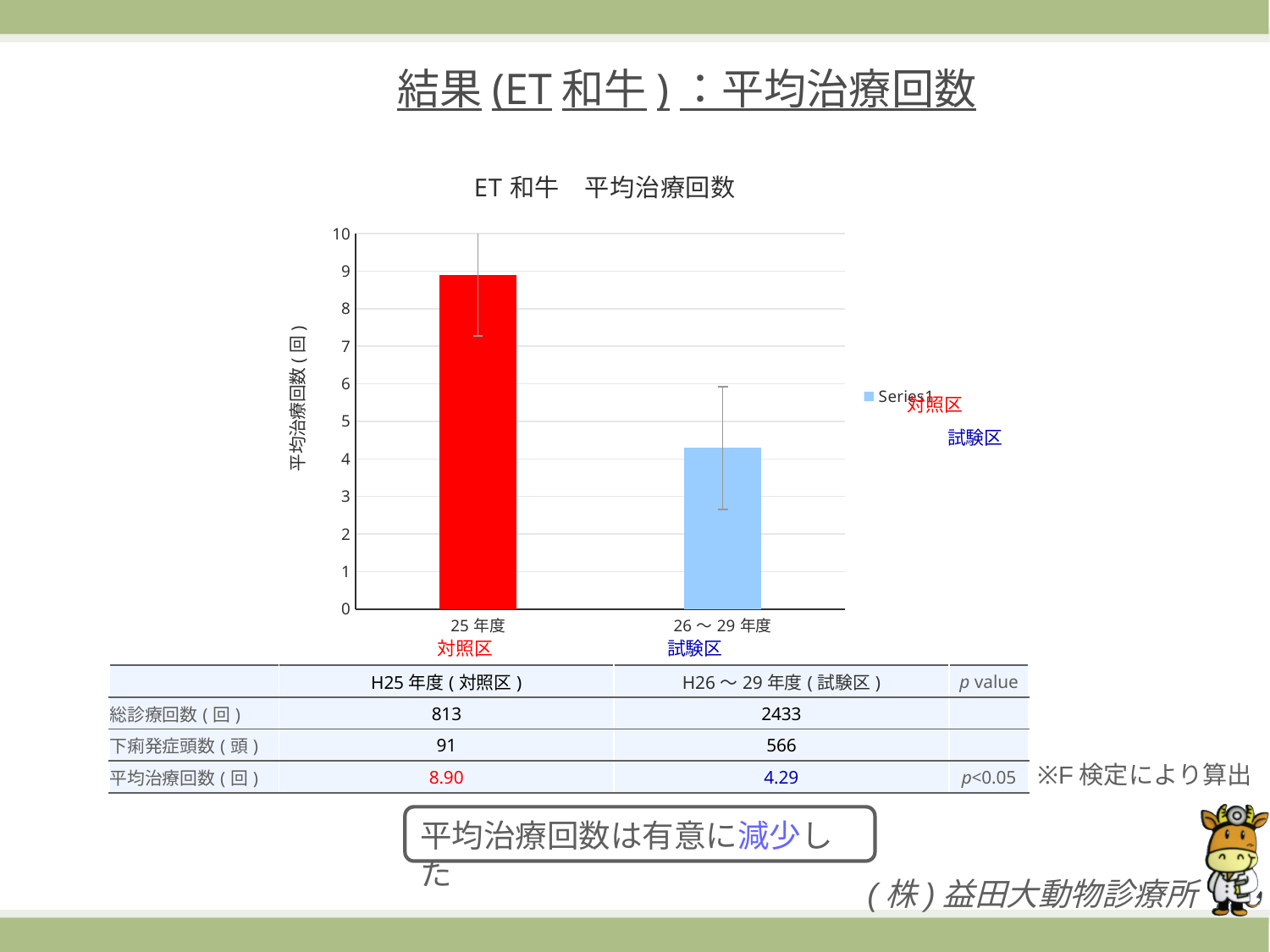
Is the value for 25 年度 (対照区) greater or less than 8? greater Do the values rise or fall from 25 年度 to 26 ～ 29 年度 along the x axis? fall What is the average treatment count (平均治療回数) for the 対照区 (H25 年度) as printed on the slide? 8.90 Which category has the lowest average treatment count (平均治療回数)? 26 ～ 29 年度 (試験区) How many series does the chart legend list? 1 What is the title of the chart? ET 和牛 平均治療回数 How many categories (bars) does the chart show? 2 What kind of chart is shown on the slide? bar chart Is the value for 26 ～ 29 年度 (試験区) greater or less than 5? less What is the difference between the average treatment counts of the 対照区 (8.90) and the 試験区 (4.29)? 4.61 Which category has the highest average treatment count (平均治療回数)? 25 年度 (対照区) Which is larger, the average treatment count for 25 年度 (対照区) or for 26 ～ 29 年度 (試験区)? 25 年度 (対照区)